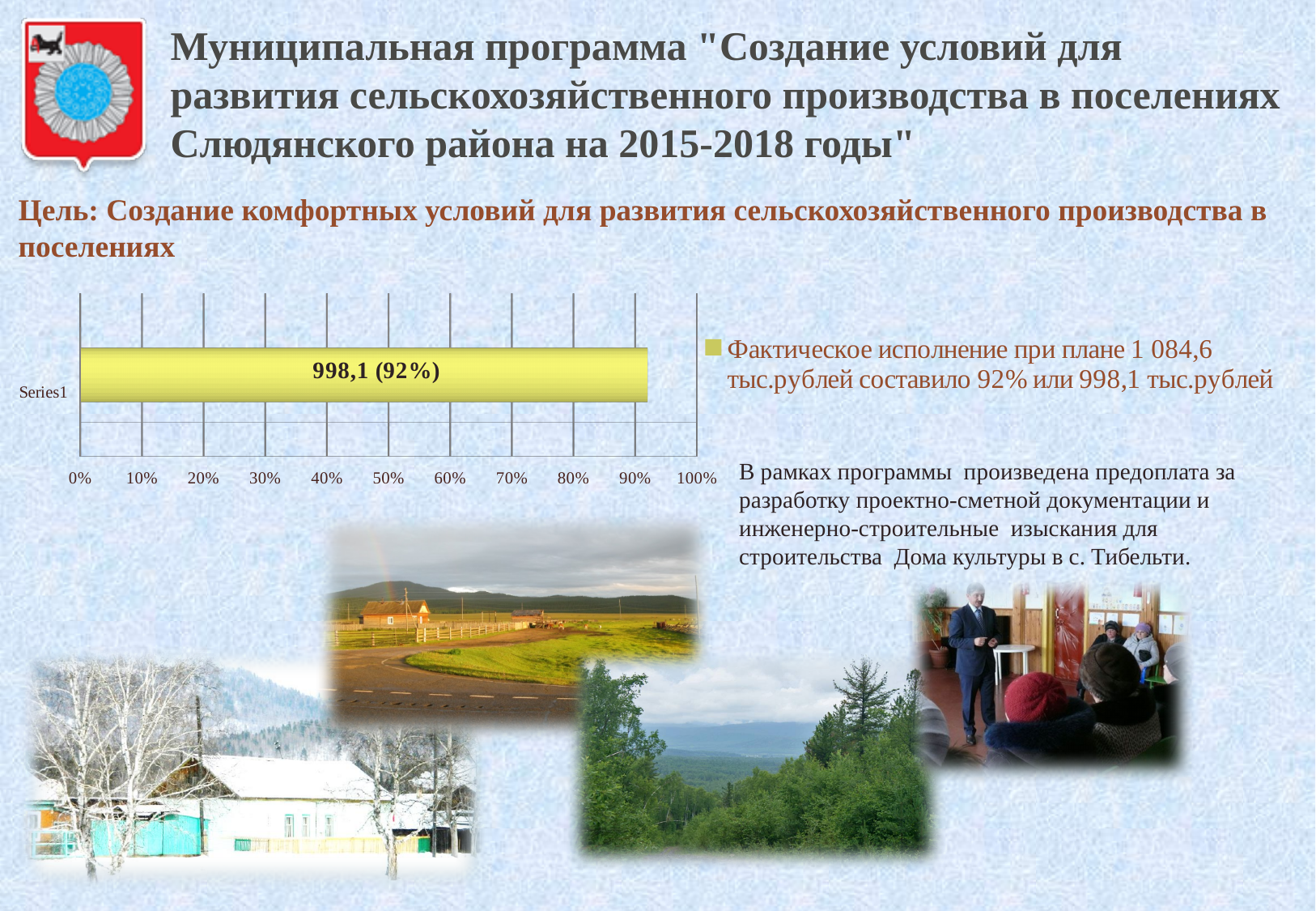
Is the value of the bar in the chart greater or less than 90%? greater Is the value of the bar in the chart greater or less than 100%? less According to the chart legend, what was the actual execution amount in thousand rubles? 998,1 How many bars are plotted in the chart? 1 What kind of chart is shown on the slide? bar chart What data label is printed on the bar in the chart? 998,1 (92%) According to the chart legend, what was the planned amount in thousand rubles? 1 084,6 What percentage of the plan does the bar in the chart represent? 92% What is the category label shown on the vertical axis of the chart? Series1 What is the highest tick value shown on the horizontal axis of the chart? 100% How many series does the chart legend list? 1